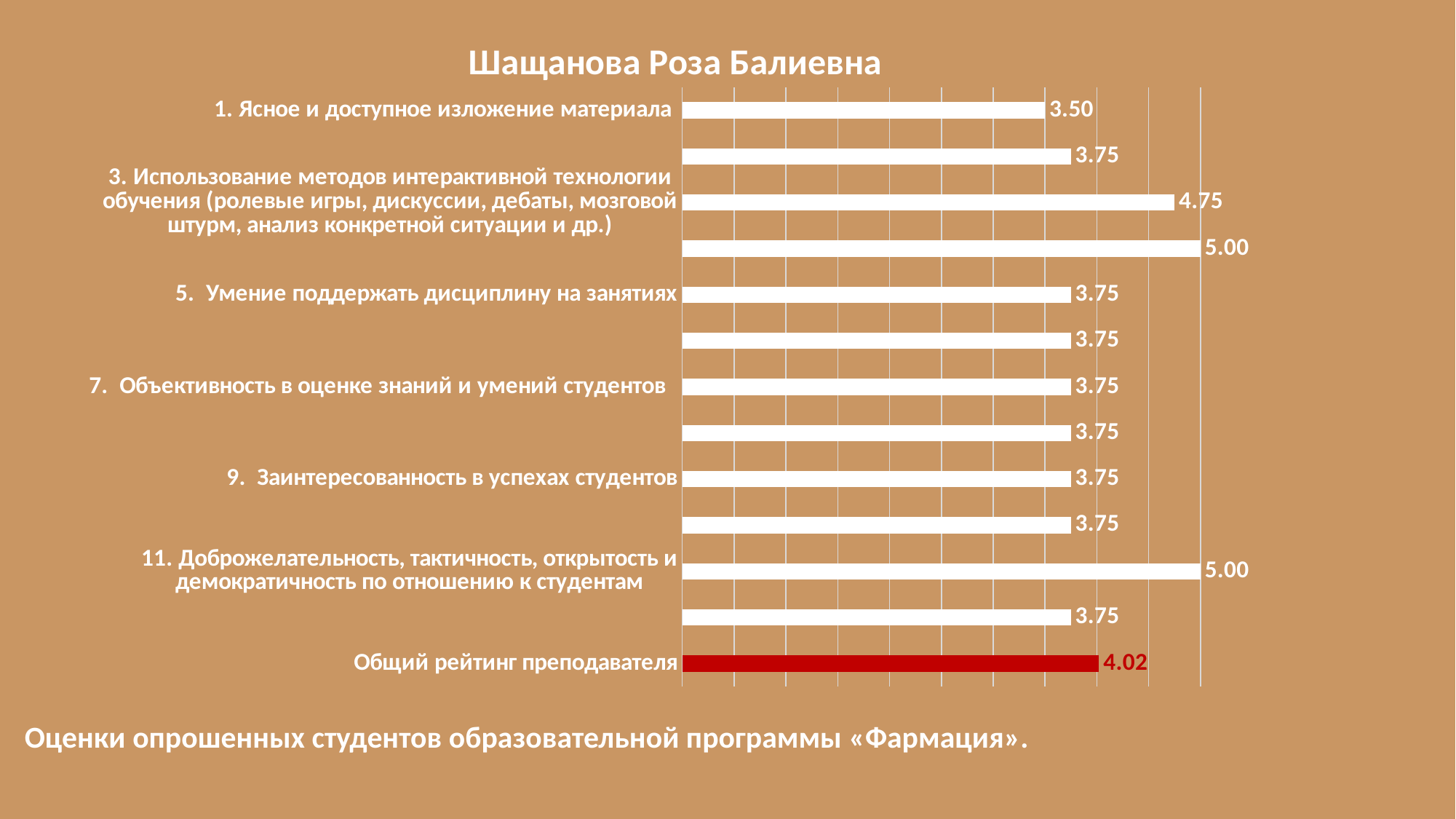
What is the value for "11. Доброжелательность, тактичность, открытость и демократичность по отношению к студентам"? 5.00 What kind of chart is shown on the slide? Bar chart What is the value for "1. Ясное и доступное изложение материала"? 3.50 What is the value for "3. Использование методов интерактивной технологии обучения (ролевые игры, дискуссии, дебаты, мозговой штурм, анализ конкретной ситуации и др.)"? 4.75 What is the title of the chart? Шащанова Роза Балиевна Which is larger: the value for "3. Использование методов интерактивной технологии обучения" or the value for "7. Объективность в оценке знаний и умений студентов"? 3. Использование методов интерактивной технологии обучения What is the difference between the value for "11. Доброжелательность, тактичность, открытость и демократичность по отношению к студентам" and the value for "1. Ясное и доступное изложение материала"? 1.50 What colour is the bar for "Общий рейтинг преподавателя"? Red What is the value for "5. Умение поддержать дисциплину на занятиях"? 3.75 How many bars are plotted in the chart? 13 Which category has the lowest value? 1. Ясное и доступное изложение материала What is the value for "Общий рейтинг преподавателя"? 4.02